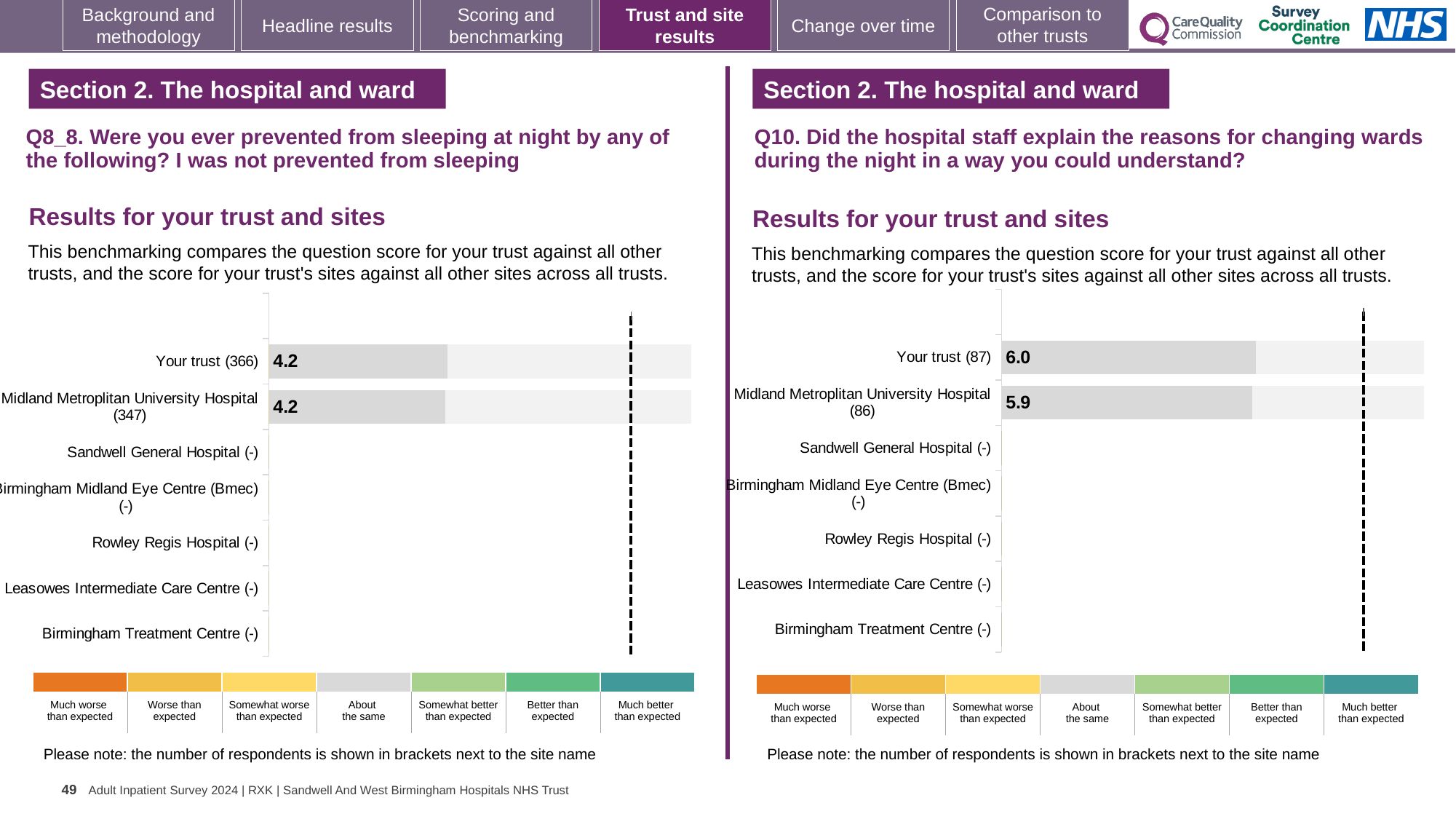
On the right chart (Q10), what is the score for Midland Metropolitan University Hospital? 5.9 On the right chart (Q10), which has the higher score: Your trust or Midland Metropolitan University Hospital? Your trust On the left chart (Q8_8), what is the score for Your trust? 4.2 On the left chart (Q8_8), what is the score for Midland Metropolitan University Hospital? 4.2 On the right chart (Q10), what is the score for Your trust? 6.0 On the left chart (Q8_8), how many respondents are shown in brackets for Your trust? 366 On the right chart (Q10), what is the difference between the score for Your trust and the score for Midland Metropolitan University Hospital? 0.1 How many site/trust categories are listed on the right chart (Q10)? 7 On the right chart (Q10), how many respondents are shown in brackets for Midland Metropolitan University Hospital? 86 How many site/trust categories are listed on the left chart (Q8_8)? 7 What kind of chart is used on the left (Q8_8)? Bar chart How many benchmark categories are shown in the colour key below the left chart (Q8_8)? 7